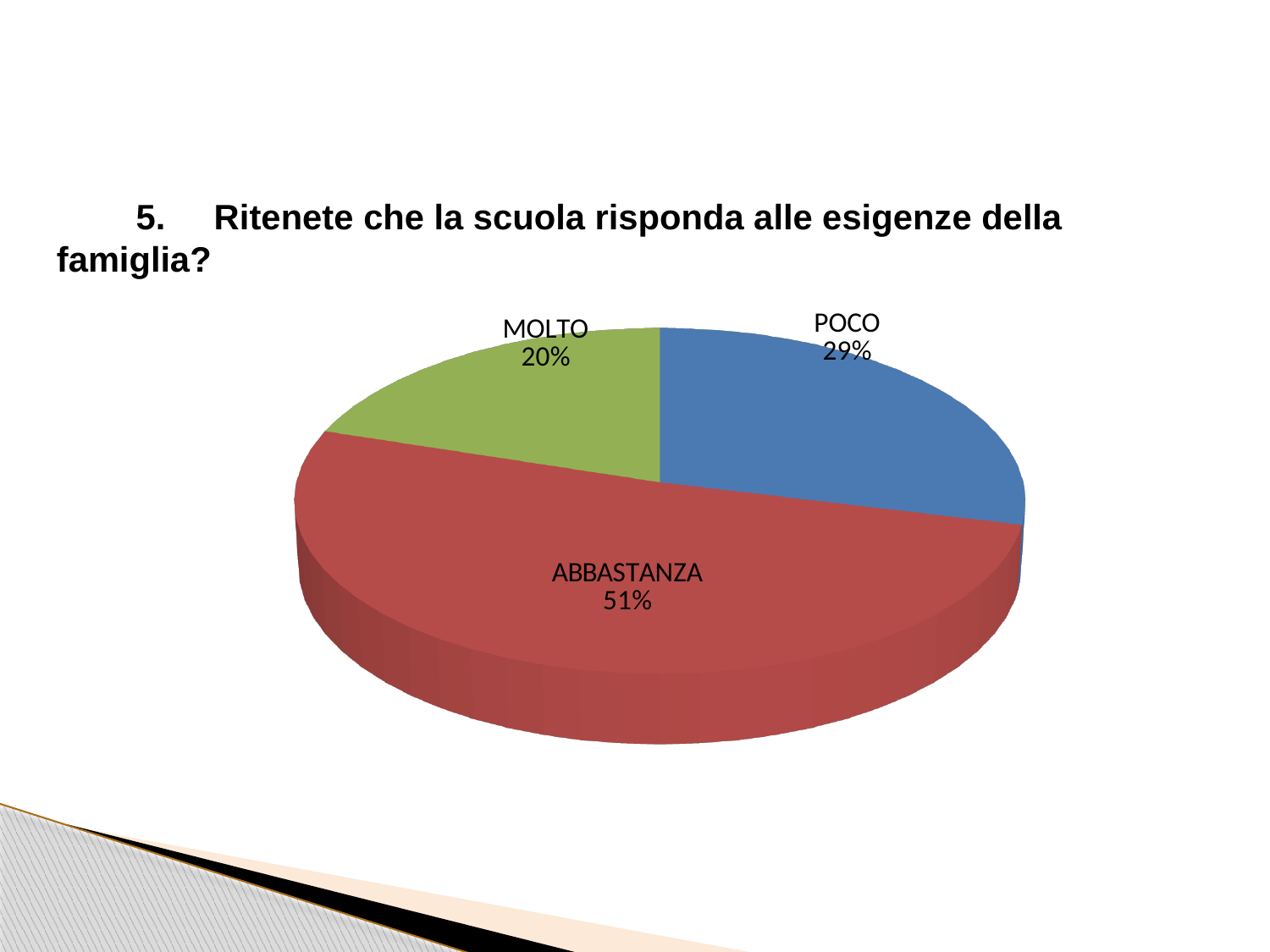
What is the difference in percentage points between the ABBASTANZA slice and the POCO slice? 22 What kind of chart is shown on the slide? pie chart How many slices does the pie chart have? 3 What colour is the MOLTO slice? green Which slice of the pie is the largest? ABBASTANZA What percentage of the pie is labelled ABBASTANZA? 51% Which slice of the pie is the smallest? MOLTO What percentage of the pie is labelled MOLTO? 20% What percentage of the pie is labelled POCO? 29% What is the difference in percentage points between the POCO slice and the MOLTO slice? 9 Which slice is larger, POCO or MOLTO? POCO What colour is the ABBASTANZA slice? red